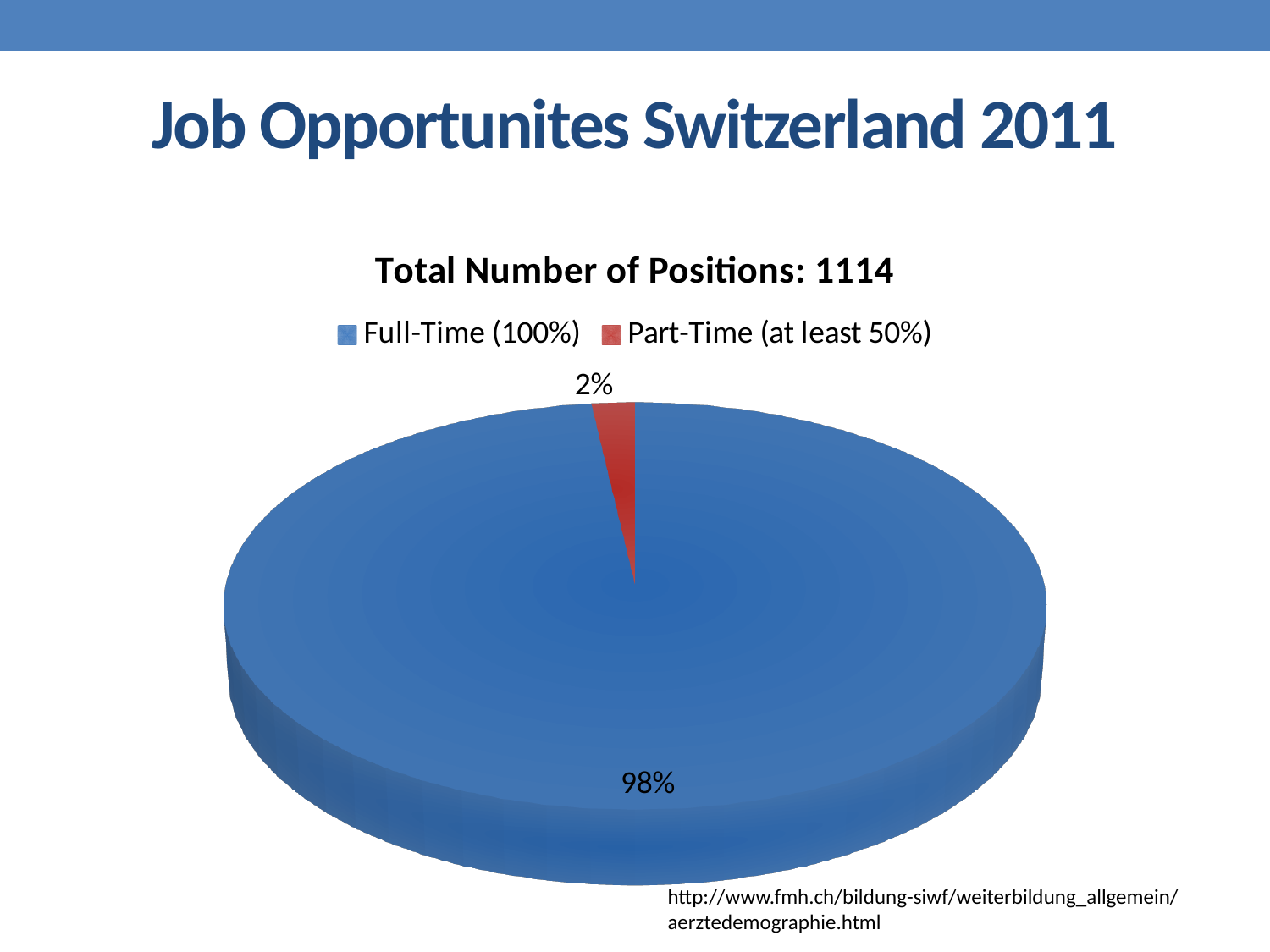
What share of the pie does Part-Time (at least 50%) represent? 2% What is the title of the chart? Total Number of Positions: 1114 What colour is the Part-Time (at least 50%) slice? red Which category has the smallest slice of the pie? Part-Time (at least 50%) What share of the pie does Full-Time (100%) represent? 98% Which category has the largest slice of the pie? Full-Time (100%) Which is larger, the Full-Time (100%) slice or the Part-Time (at least 50%) slice? Full-Time (100%) How many categories does the pie chart show? 2 What kind of chart is shown on the slide? pie chart How many entries does the legend list? 2 What is the difference in percentage points between the Full-Time (100%) and Part-Time (at least 50%) slices? 96